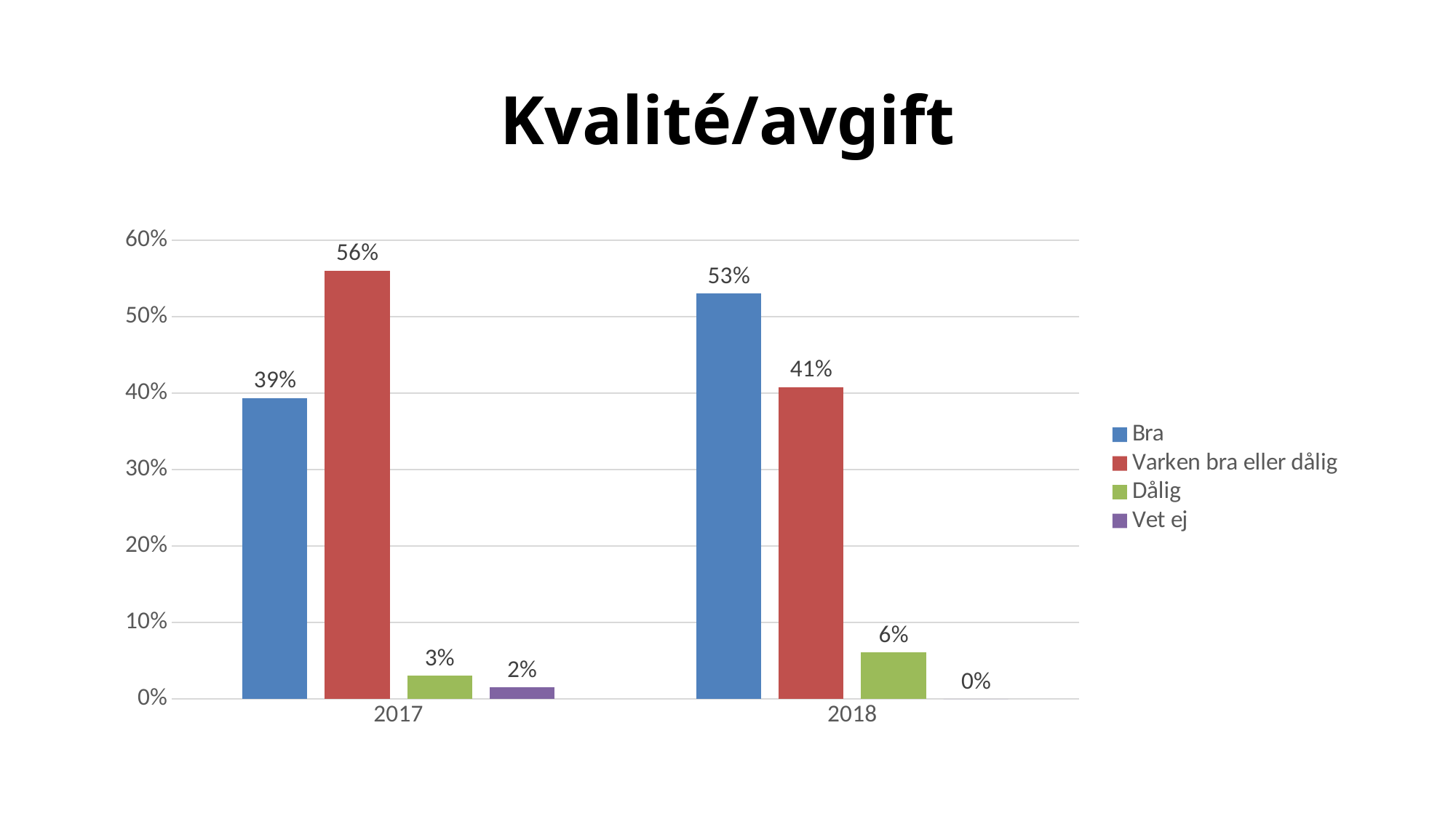
What kind of chart is shown on the slide? Bar chart Which is larger in 2018, Bra or Varken bra eller dålig? Bra What is the value for Vet ej in 2017? 2% What is the value for Bra in 2017? 39% How many series does the legend list? 4 What is the value for Dålig in 2018? 6% What is the value for Varken bra eller dålig in 2018? 41% What is the title of the chart? Kvalité/avgift Which series has the highest value in 2017? Varken bra eller dålig Which series has the lowest value in 2018? Vet ej Is the value for Varken bra eller dålig in 2017 greater or less than 50%? greater What is the difference between the Bra values for 2018 and 2017? 14%